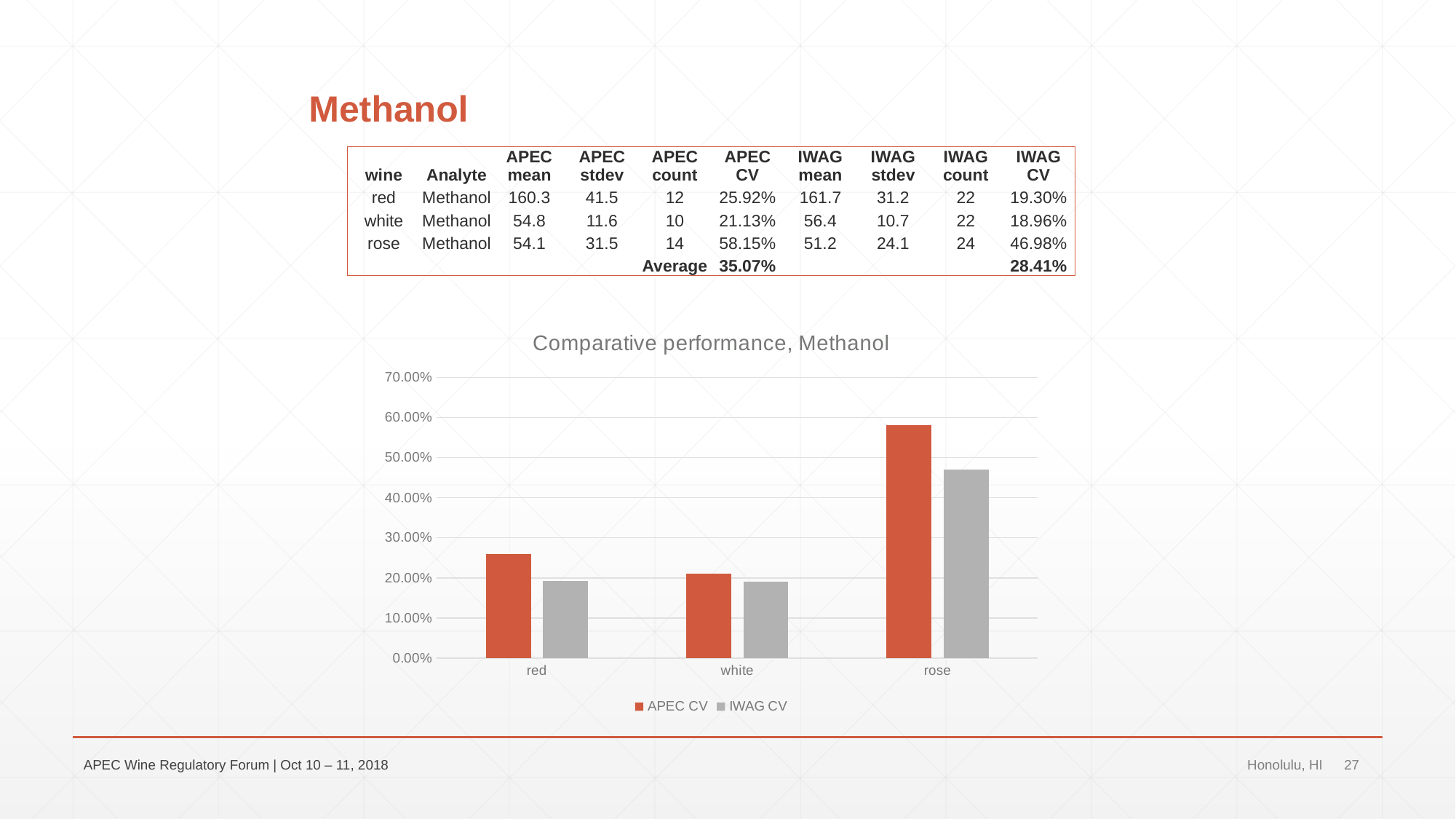
For red wine, which is larger in the chart: APEC CV or IWAG CV? APEC CV What kind of chart is shown on the slide? bar chart Which wine has the lowest APEC CV in the chart? white Which wine has the highest APEC CV in the chart? rose How many wine categories are shown on the x axis of the chart? 3 What is the APEC CV value for rose, as printed in the table above the chart? 58.15% Is the APEC CV value for rose greater or less than 50%? greater How many series does the legend of the chart list? 2 Using the values printed in the table, what is the difference between the APEC CV and IWAG CV for rose? 11.17% What is the title of the chart? Comparative performance, Methanol What is the IWAG CV value for red, as printed in the table above the chart? 19.30% Is the IWAG CV value for white greater or less than 20%? less